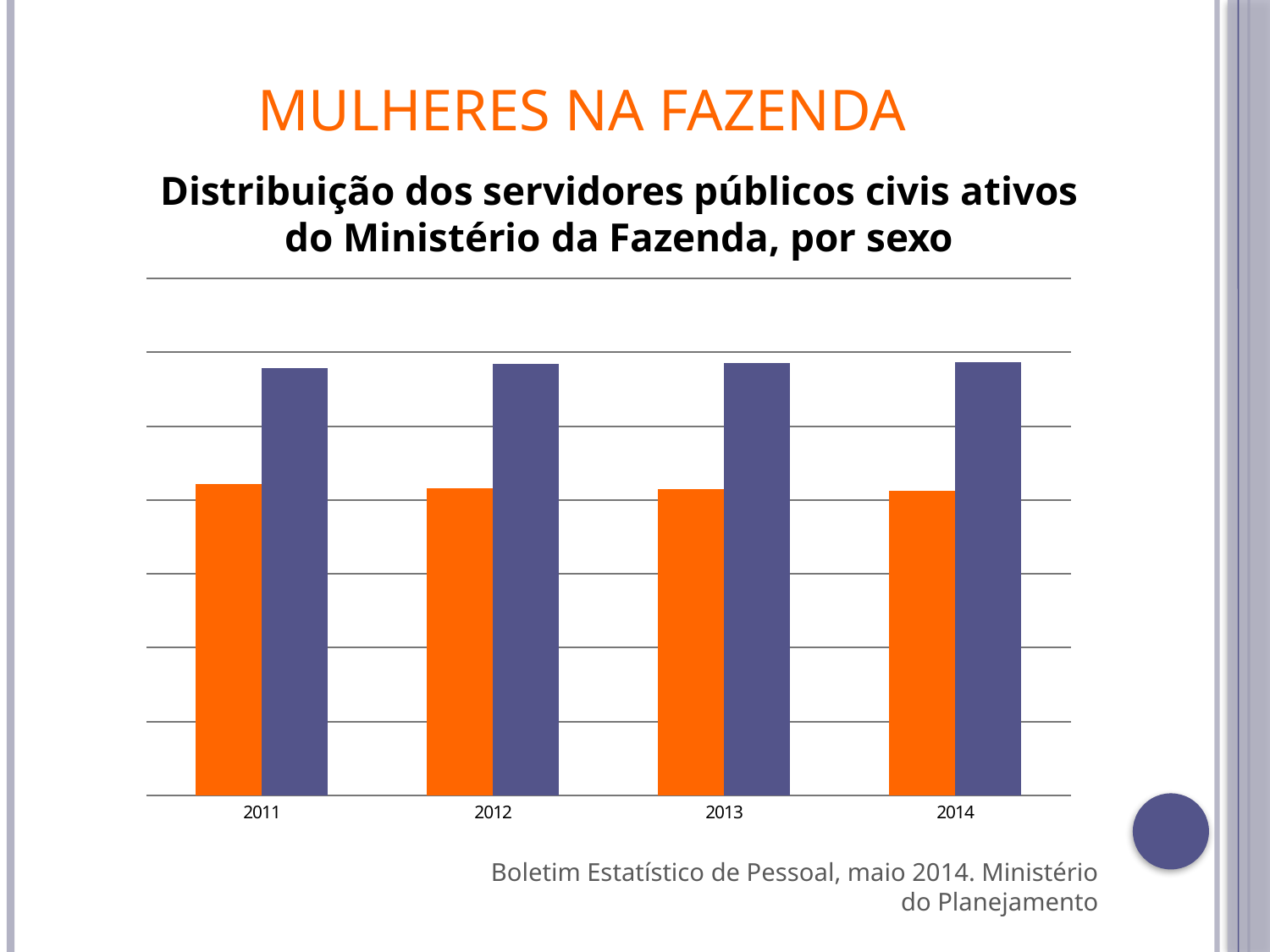
In 2014, is the blue bar taller or shorter than the orange bar? taller Which years are labelled on the x axis of the chart? 2011, 2012, 2013, 2014 What kind of chart is shown on the slide? bar chart In 2012, is the orange bar taller or shorter than the blue bar? shorter How many data series (bar colours) are plotted for each year? 2 In 2013, which bar is taller, the orange one or the blue one? the blue one How many years are shown on the x axis of the chart? 4 What is the title of the chart? Distribuição dos servidores públicos civis ativos do Ministério da Fazenda, por sexo